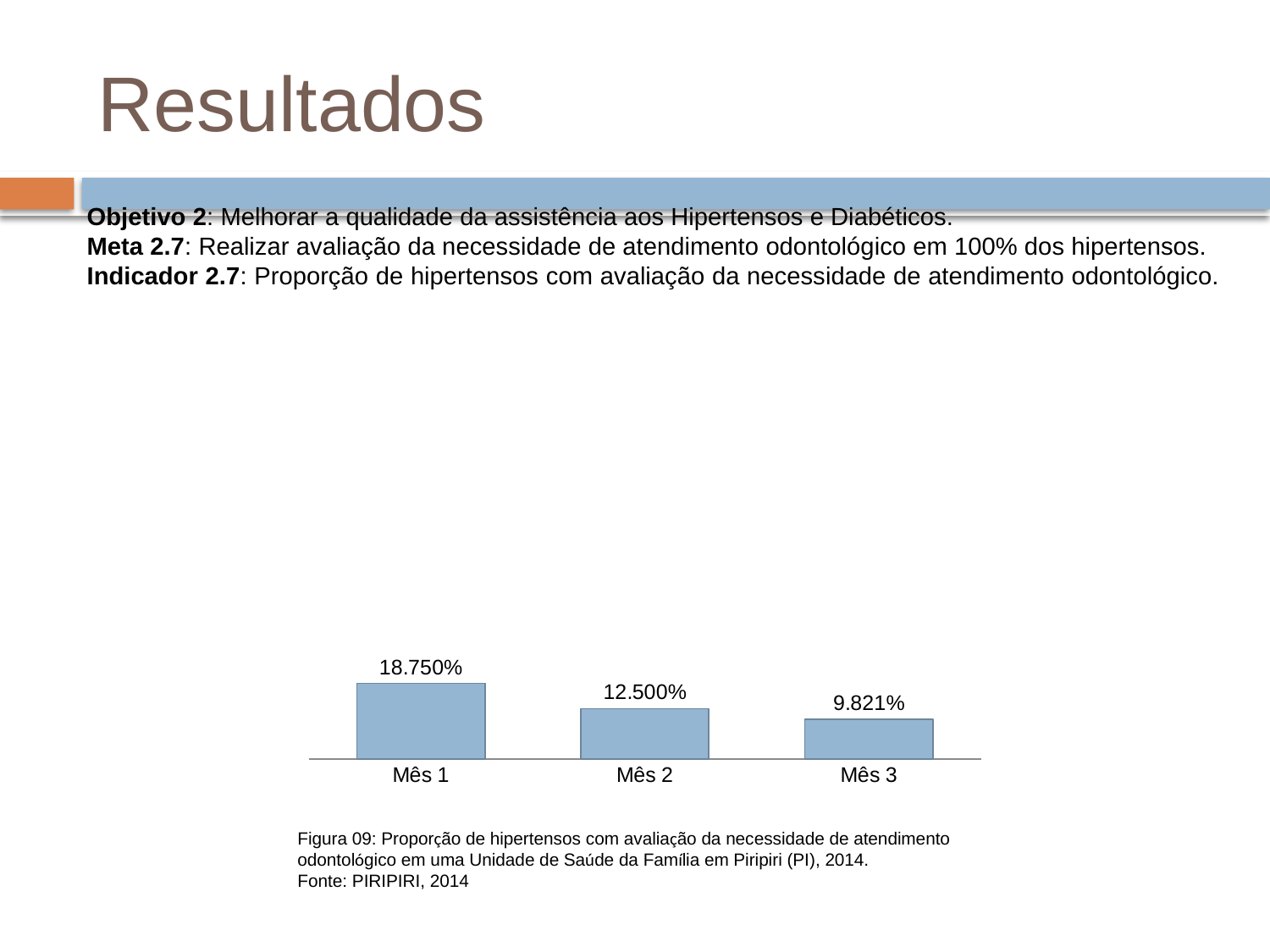
Which month has the highest value? Mês 1 What kind of chart is shown on the slide? Bar chart Which is larger, the value for Mês 1 or the value for Mês 3? Mês 1 How many categories are shown on the x axis? 3 Do the values rise or fall from Mês 1 to Mês 3? Fall What is the value for Mês 2? 12.500% What is the value for Mês 1? 18.750% What is the difference between the values for Mês 2 and Mês 3? 2.679% Which month has the lowest value? Mês 3 What is the value for Mês 3? 9.821% What is the difference between the values for Mês 1 and Mês 2? 6.250% What is the figure number given in the caption below the chart? Figura 09